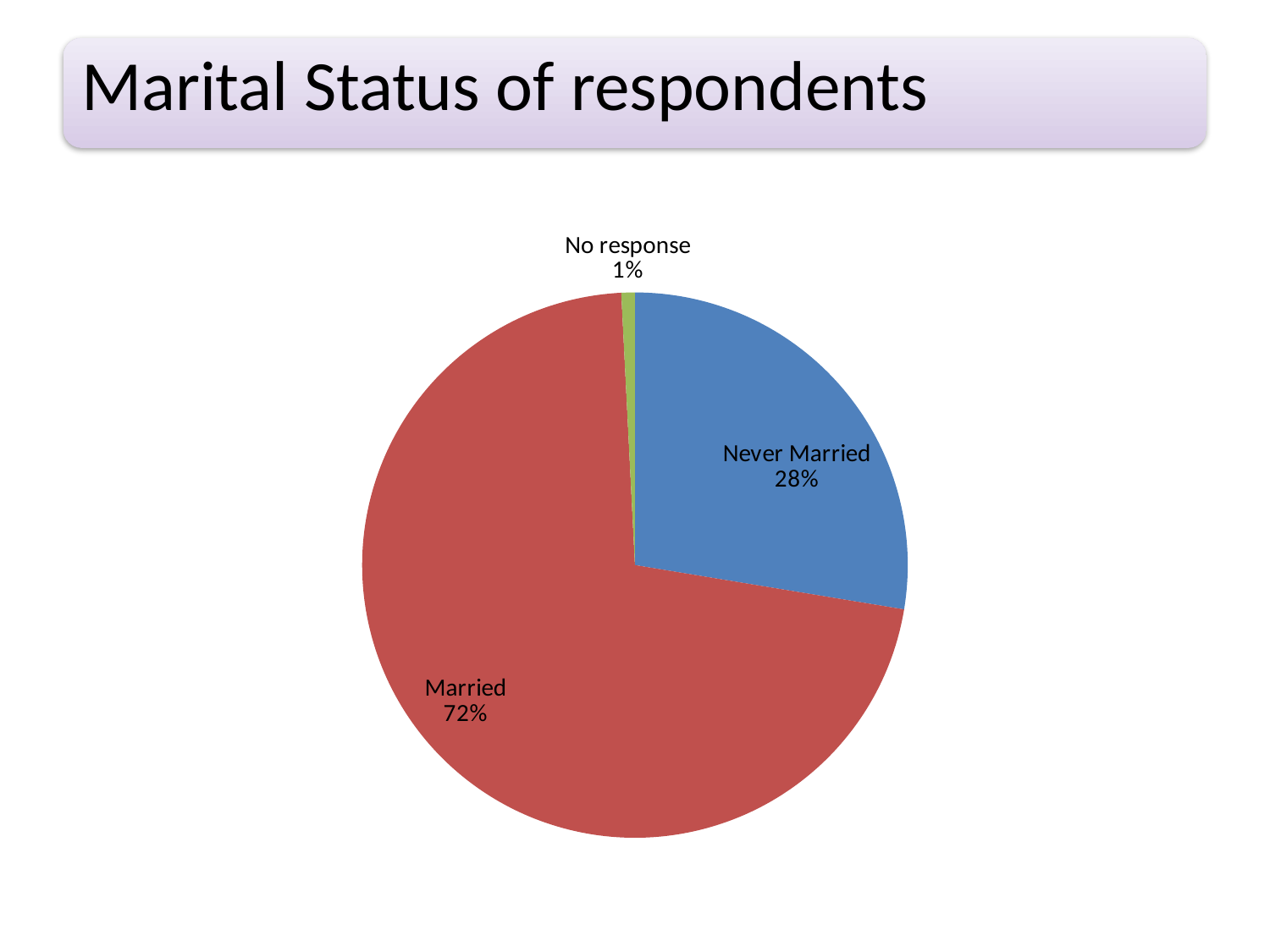
What percentage of respondents are Never Married? 28% What percentage of respondents gave No response? 1% How many categories are shown in the pie chart? 3 Which category has the largest share of the pie? Married Which is larger, the share for Never Married or the share for No response? Never Married What share of the pie does the Married slice represent? 72% What colour is the Married slice? red What is the difference in percentage points between Married and Never Married? 44 Which category has the smallest share of the pie? No response What percentage of respondents are Married? 72% What kind of chart is shown on the slide? pie chart What is the title of the slide? Marital Status of respondents